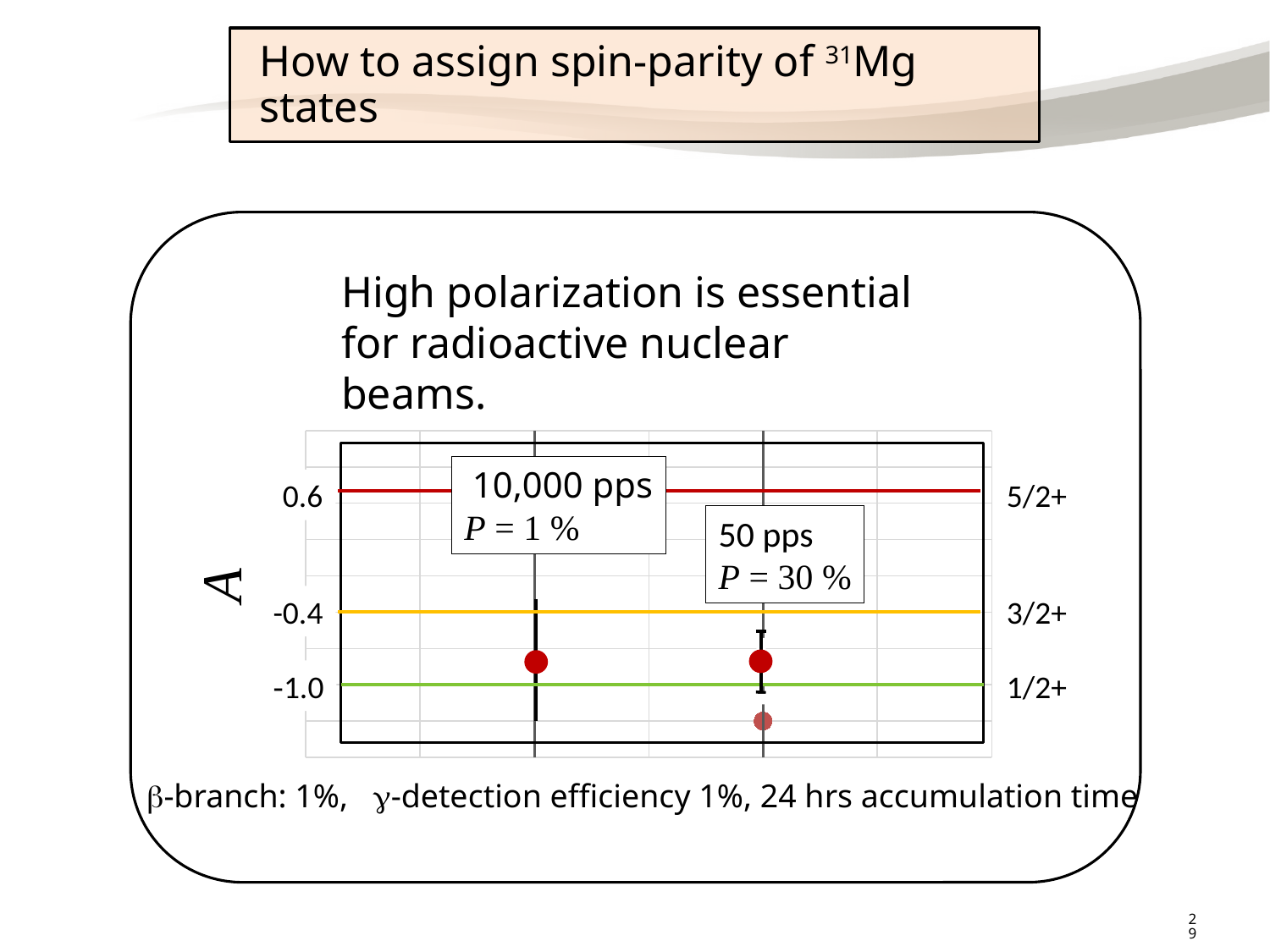
What value of A does the horizontal line labelled 1/2+ sit at? -1.0 What colour is the reference line for 5/2+? Red What is the difference in A between the 5/2+ line and the 3/2+ line? 1.0 How many spin-parity reference lines are drawn on the chart? 3 What is the difference in A between the 3/2+ line and the 1/2+ line? 0.6 Which spin-parity reference line has the lowest value of A? 1/2+ Is the value of A for the 10,000 pps, P = 1 % data point greater or less than -0.4? less What value of A does the horizontal line labelled 3/2+ sit at? -0.4 What value of A does the horizontal line labelled 5/2+ sit at? 0.6 What is the label on the vertical axis of the chart? A Which reference line has a larger value of A, 3/2+ or 1/2+? 3/2+ Which spin-parity reference line has the highest value of A? 5/2+